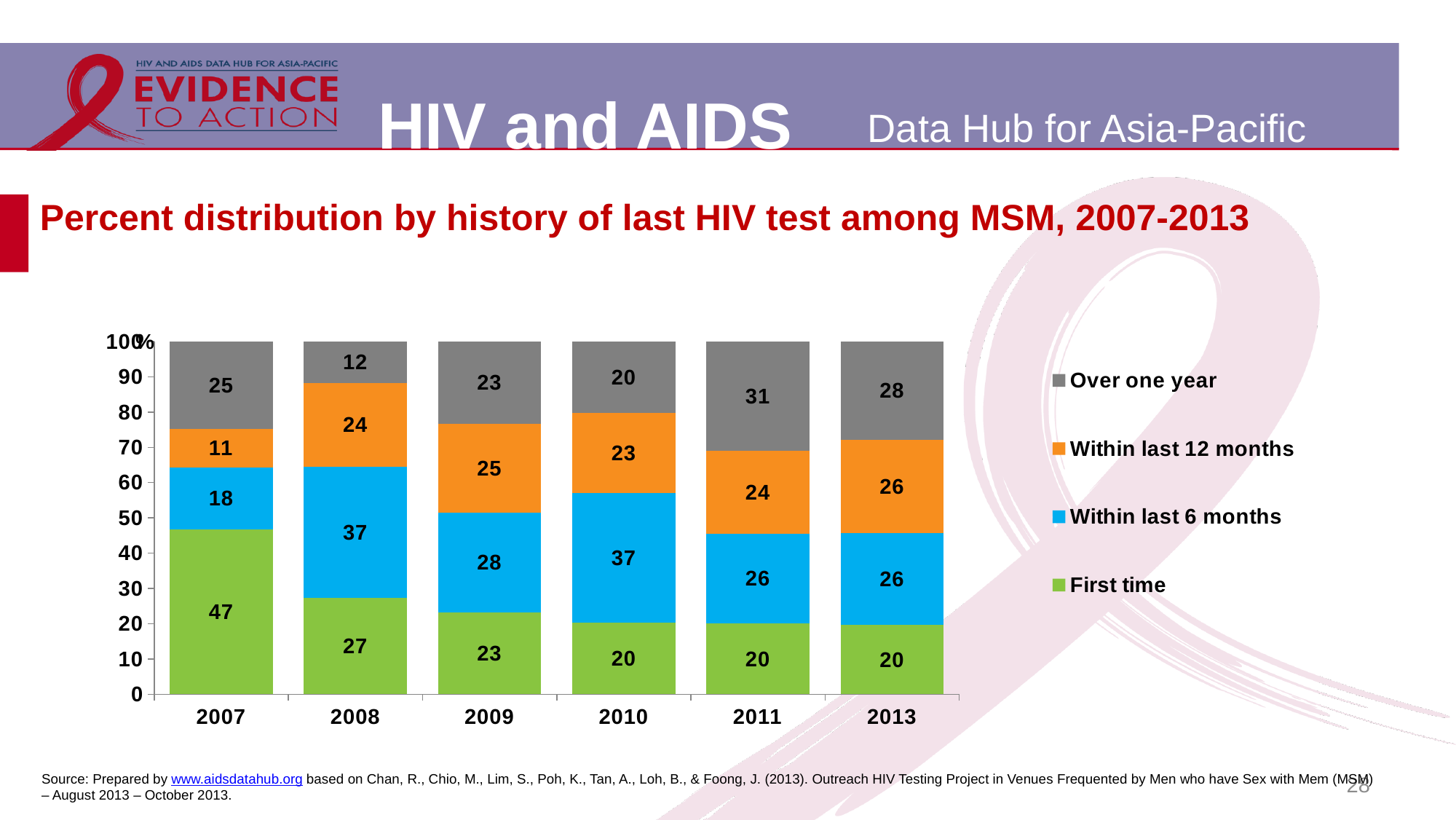
What kind of chart is shown on the slide? Stacked bar chart How many years are shown on the x axis? 6 What is the value for Within last 12 months in 2008? 24 Which is larger in 2009: Within last 6 months or Within last 12 months? Within last 6 months Does the First time value rise or fall from 2007 to 2013? Fall In which year is the Over one year value lowest? 2008 What is the value for Within last 6 months in 2010? 37 What is the value for First time in 2007? 47 How many series does the legend list? 4 What is the value for Over one year in 2011? 31 What is the difference between the First time values for 2007 and 2008? 20 In which year is the First time value highest? 2007